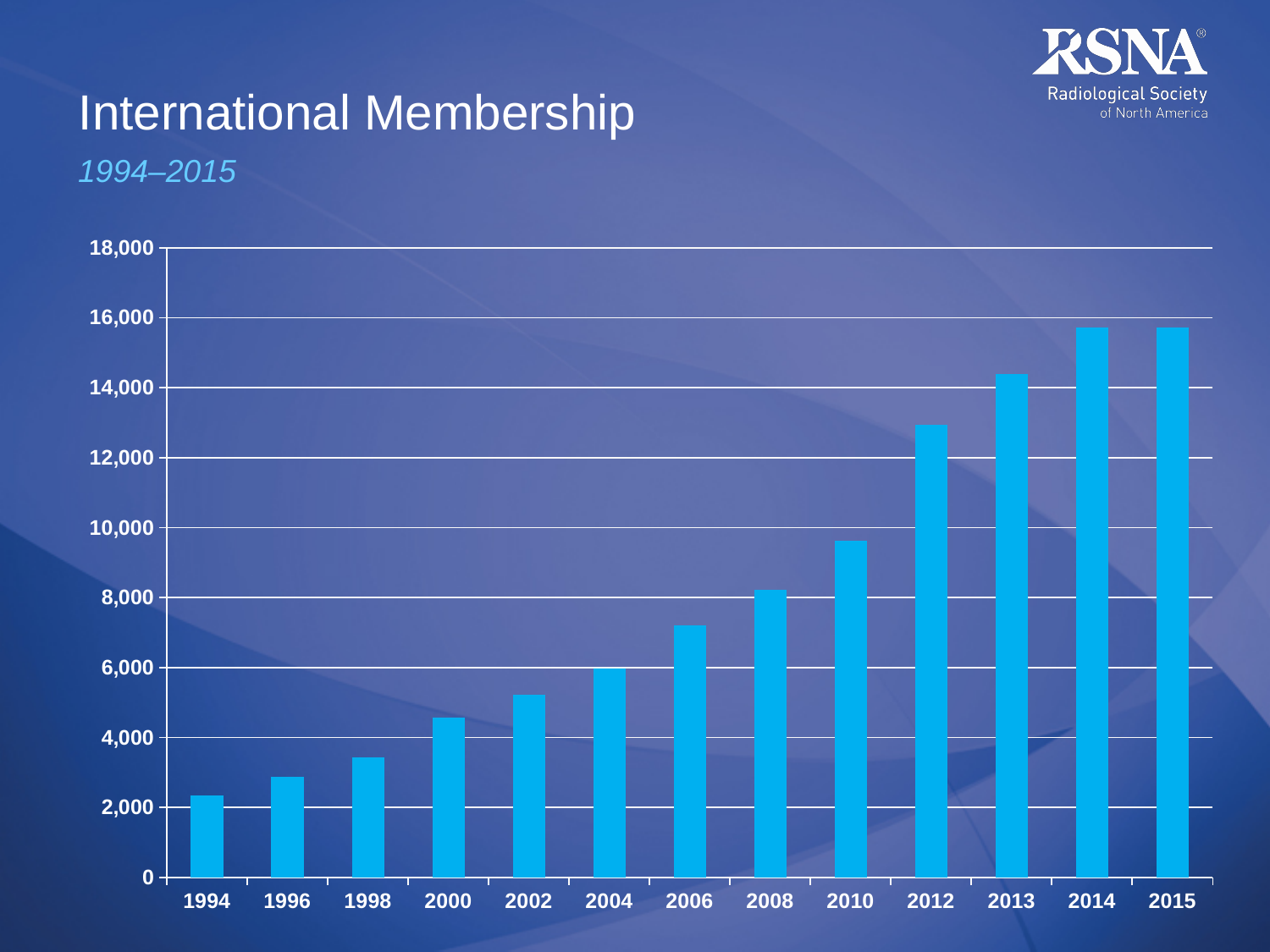
Is the value for 2012 greater or less than 12,000? greater What kind of chart is shown on the slide? bar chart Do the values generally rise or fall from 1994 to 2015? rise Is the value for 2006 greater or less than 8,000? less Which year has the larger value, 2008 or 2002? 2008 Is the value for 2010 greater or less than 10,000? less What is the title of the chart on the slide? International Membership Which year has the lowest international membership? 1994 Which year has the larger value, 1998 or 2012? 2012 How many years are plotted on the x axis of the chart? 13